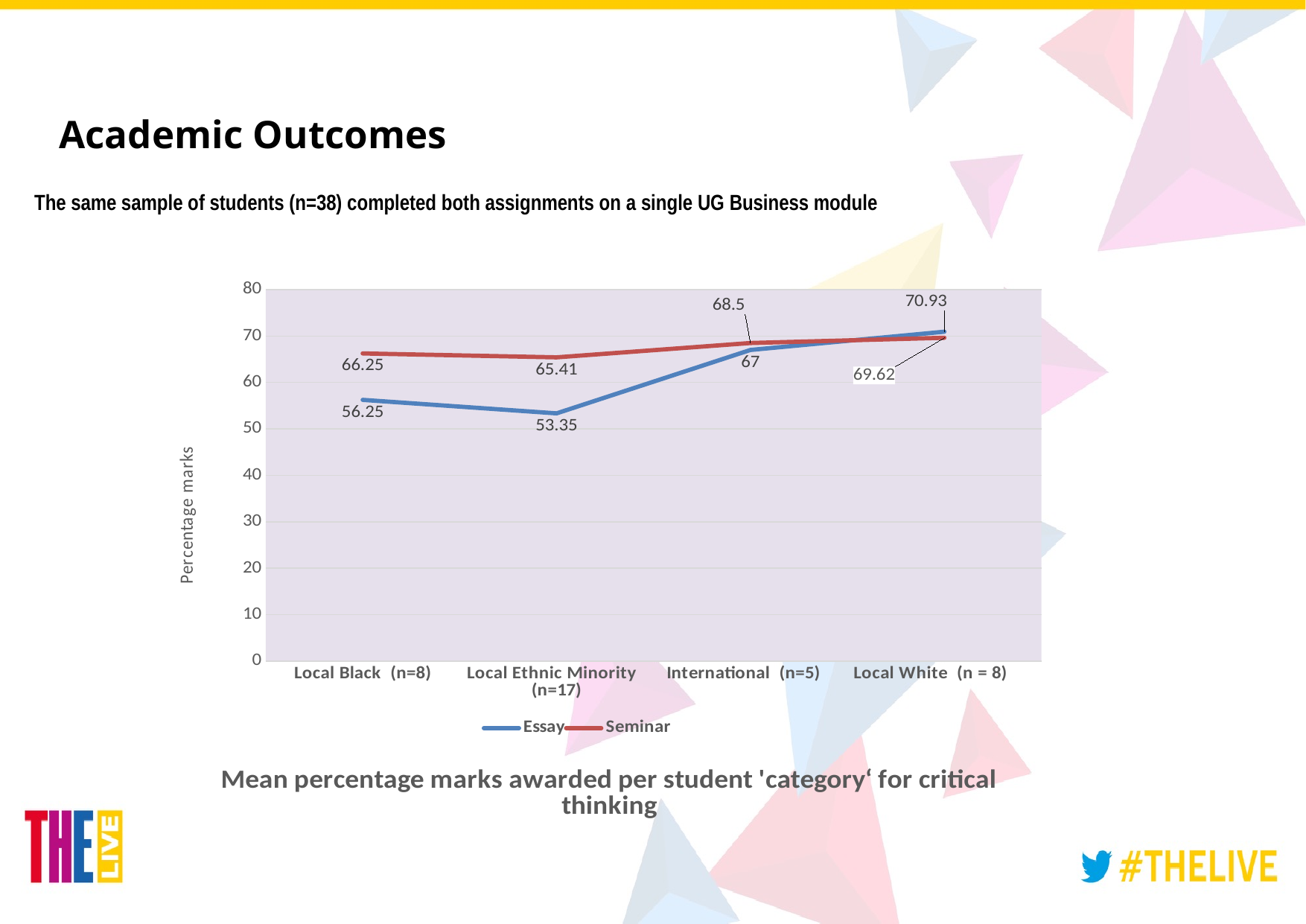
Which is larger for Local Ethnic Minority (n=17), the Essay value or the Seminar value? Seminar Which category has the lowest Essay value? Local Ethnic Minority (n=17) How many series does the legend list? 2 What is the Essay value for Local Black (n=8)? 56.25 What is the difference between the Seminar and Essay values for Local Black (n=8)? 10 What kind of chart is shown on the slide? Line chart How many student categories are shown on the x axis? 4 Which category has the highest Seminar value? Local White (n = 8) What is the label of the vertical axis? Percentage marks What is the Seminar value for International (n=5)? 68.5 What is the Seminar value for Local Ethnic Minority (n=17)? 65.41 What is the Essay value for Local White (n = 8)? 70.93